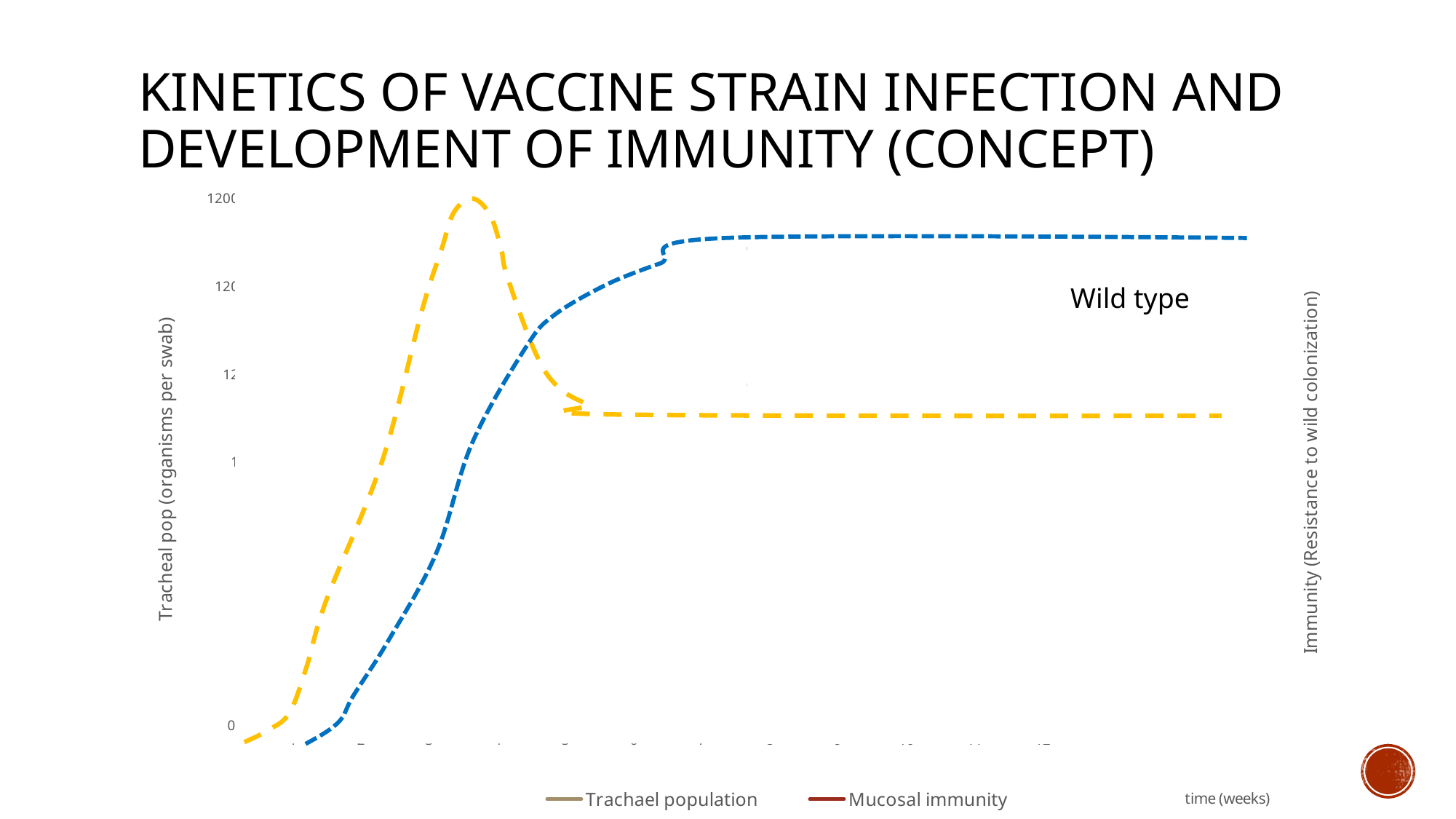
Does the yellow dashed line rise or fall after reaching its peak? Fall At the right-hand end of the chart, which line is higher, the blue dashed line or the yellow dashed line? The blue dashed line Which line reaches its peak earlier along the time axis, the yellow dashed line or the blue dashed line? The yellow dashed line What is the label on the left vertical axis? Tracheal pop (organisms per swab) What are the two series named in the legend? Trachael population and Mucosal immunity How many series does the legend list? 2 What kind of chart is shown on the slide? Line chart Does the blue dashed line rise or fall over the later part of the x axis after its initial climb? It levels off (stays roughly flat)